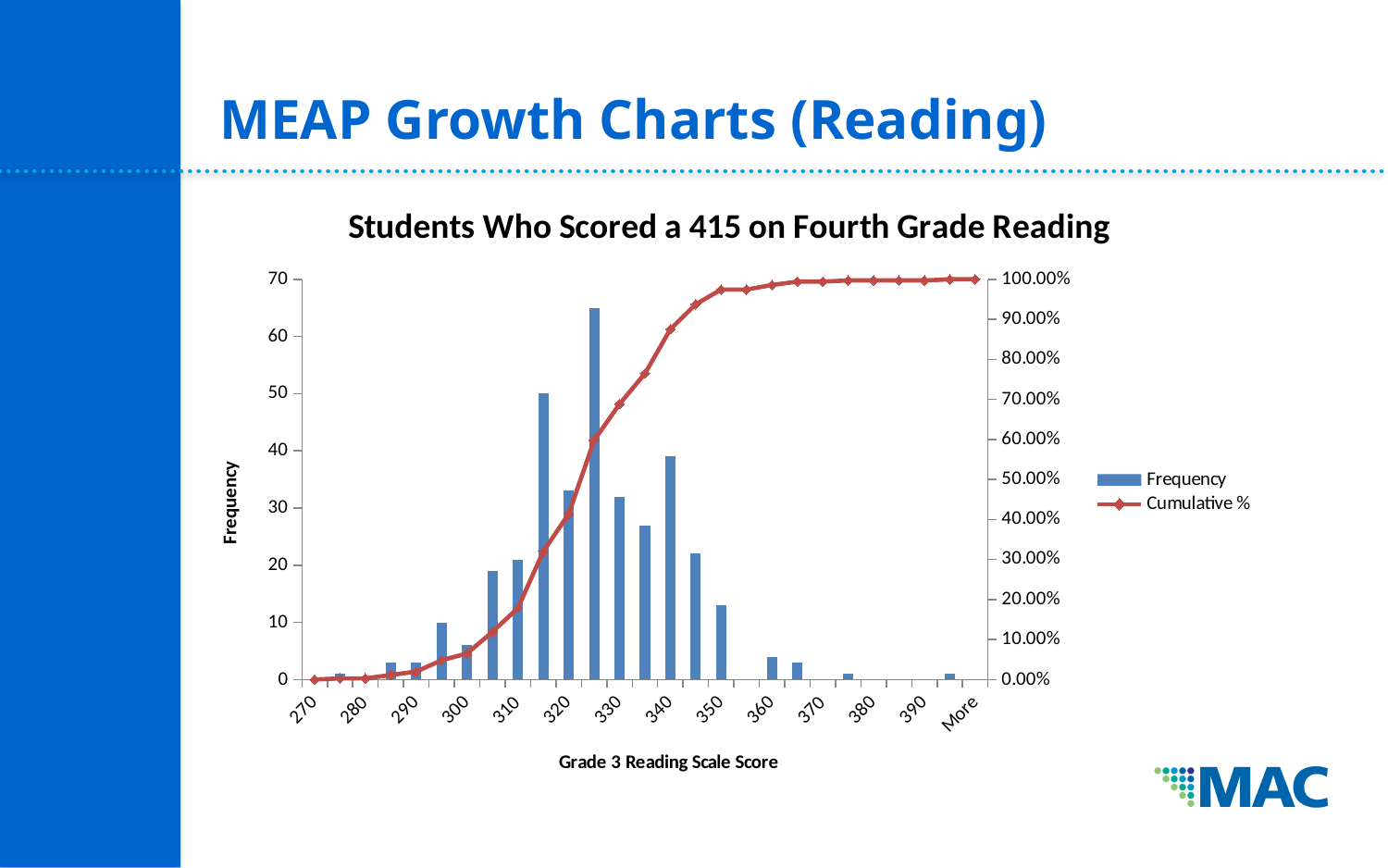
What kind of chart is used to show the Frequency series? Bar chart Is the frequency for a scale score of 350 greater or less than 10? greater How many series does the legend list? 2 What is the title of the chart? Students Who Scored a 415 on Fourth Grade Reading Is the frequency for the tallest bar greater or less than 60? greater What is the label of the x axis? Grade 3 Reading Scale Score Which has the higher frequency, a scale score of 310 or a scale score of 350? 310 How many labels are shown on the x axis? 14 Does the Cumulative % line rise or fall as the scale score increases along the x axis? Rises Is the Cumulative % at a scale score of 300 greater or less than 10.00%? less